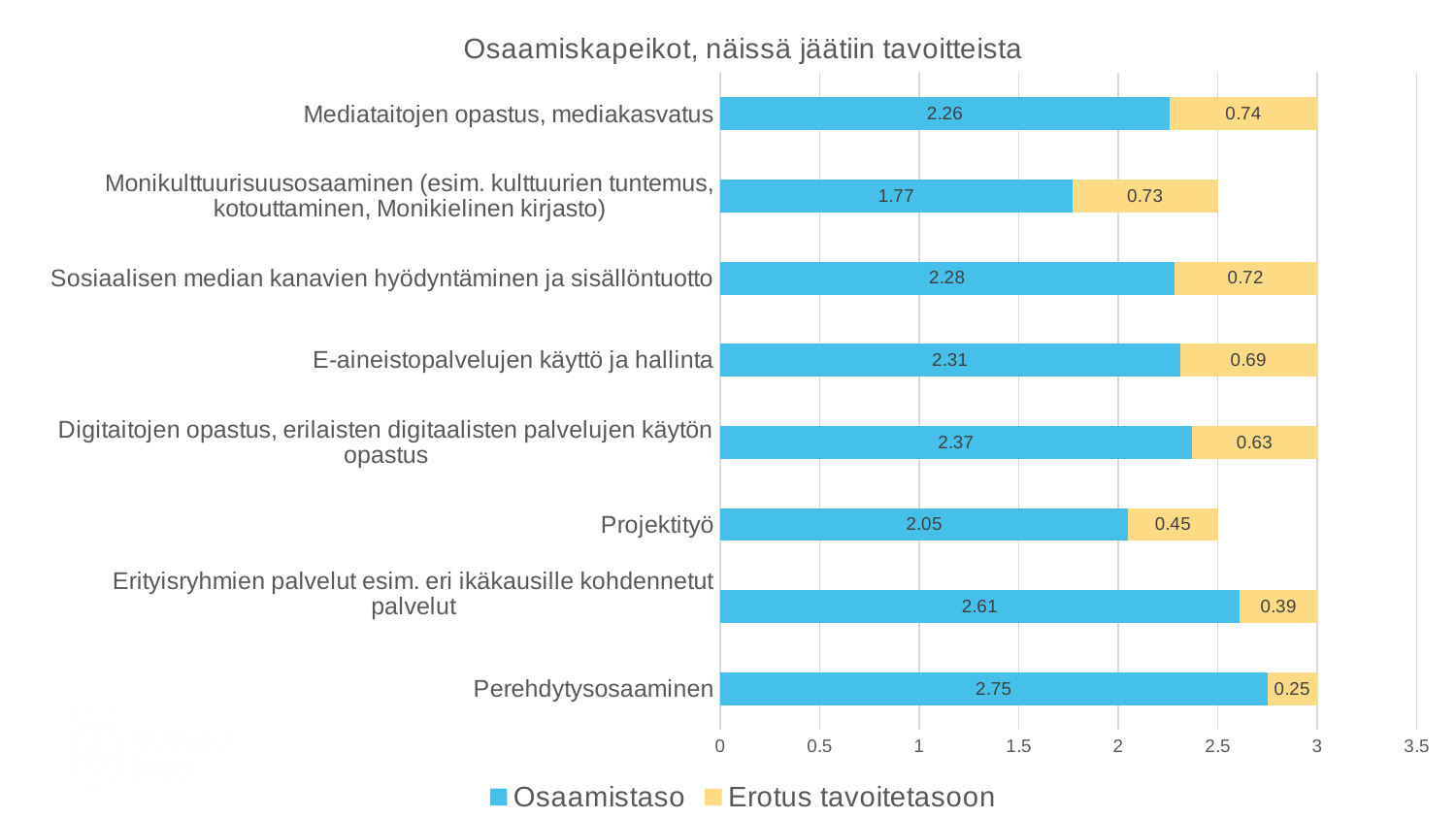
What is the Osaamistaso value for Projektityö? 2.05 Which has a larger Osaamistaso value: E-aineistopalvelujen käyttö ja hallinta or Projektityö? E-aineistopalvelujen käyttö ja hallinta What is the total of the stacked bar for Projektityö? 2.5 What is the difference between the Osaamistaso values for Perehdytysosaaminen and Projektityö? 0.7 What is the Erotus tavoitetasoon value for Mediataitojen opastus, mediakasvatus? 0.74 Which category has the smallest Erotus tavoitetasoon value? Perehdytysosaaminen Which category has the highest Osaamistaso value? Perehdytysosaaminen What type of chart is shown on the slide? Stacked bar chart Which category has the lowest Osaamistaso value? Monikulttuurisuusosaaminen (esim. kulttuurien tuntemus, kotouttaminen, Monikielinen kirjasto) What is the Osaamistaso value for Perehdytysosaaminen? 2.75 How many series does the legend list? 2 How many categories are shown in the chart? 8